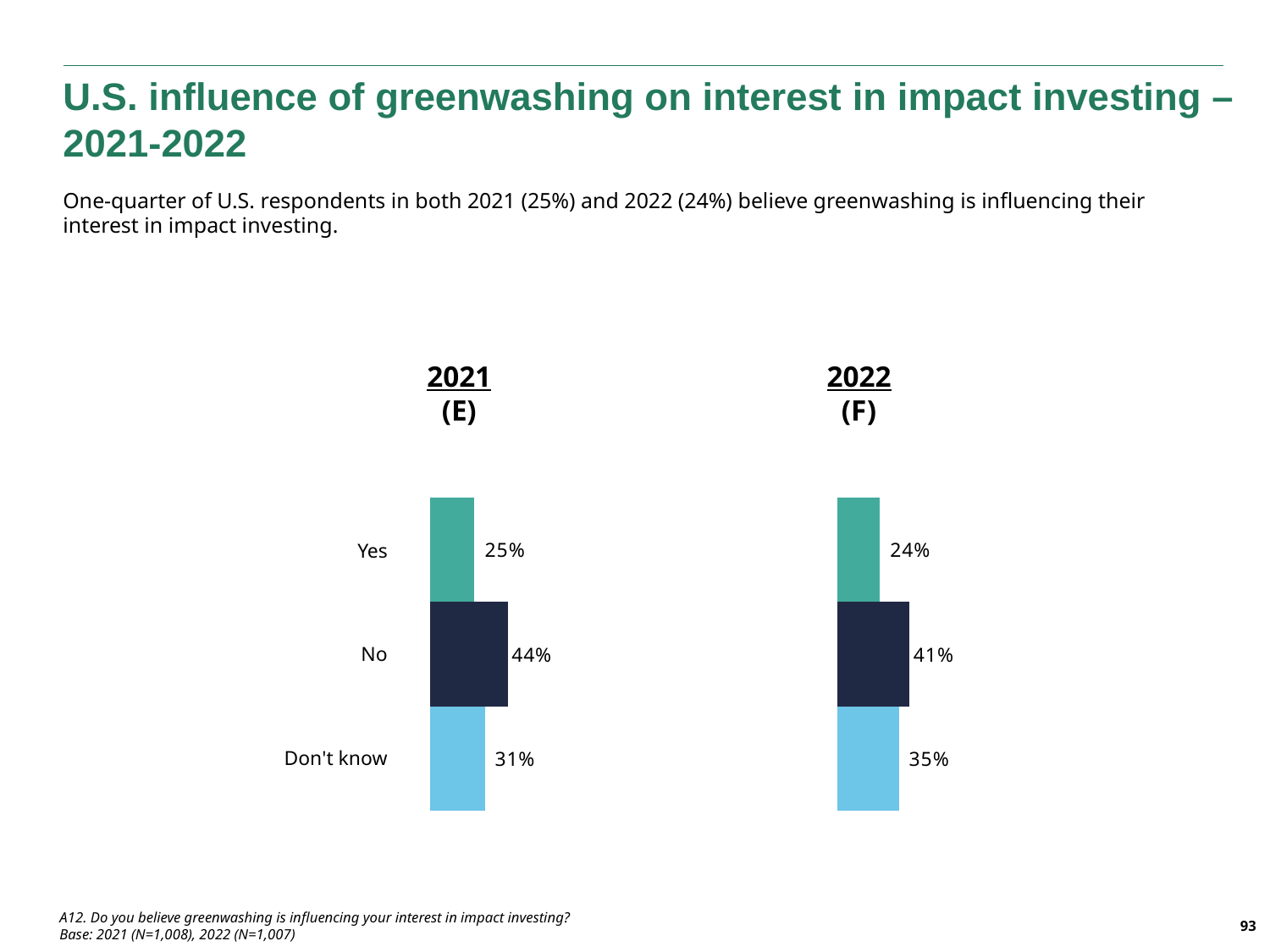
What type of chart is used for the 2022 data? Bar chart In the 2022 chart, what percentage of respondents answered Don't know? 35% Is the Don't know value larger in the 2021 chart or the 2022 chart? 2022 In the 2022 chart, what is the total of the Yes, No and Don't know values? 100% In the 2022 chart, which response category has the lowest value? Yes How many response categories are shown in the 2021 chart? 3 In the 2021 chart, what percentage of respondents answered Yes? 25% In the 2021 chart, which response category has the highest value? No What is the difference between the No values in the 2021 chart and the 2022 chart? 3% In the 2022 chart, what is the value for No? 41% What colour is the Don't know bar in the 2021 chart? Light blue In the 2021 chart, what is the difference between the No and Don't know values? 13%